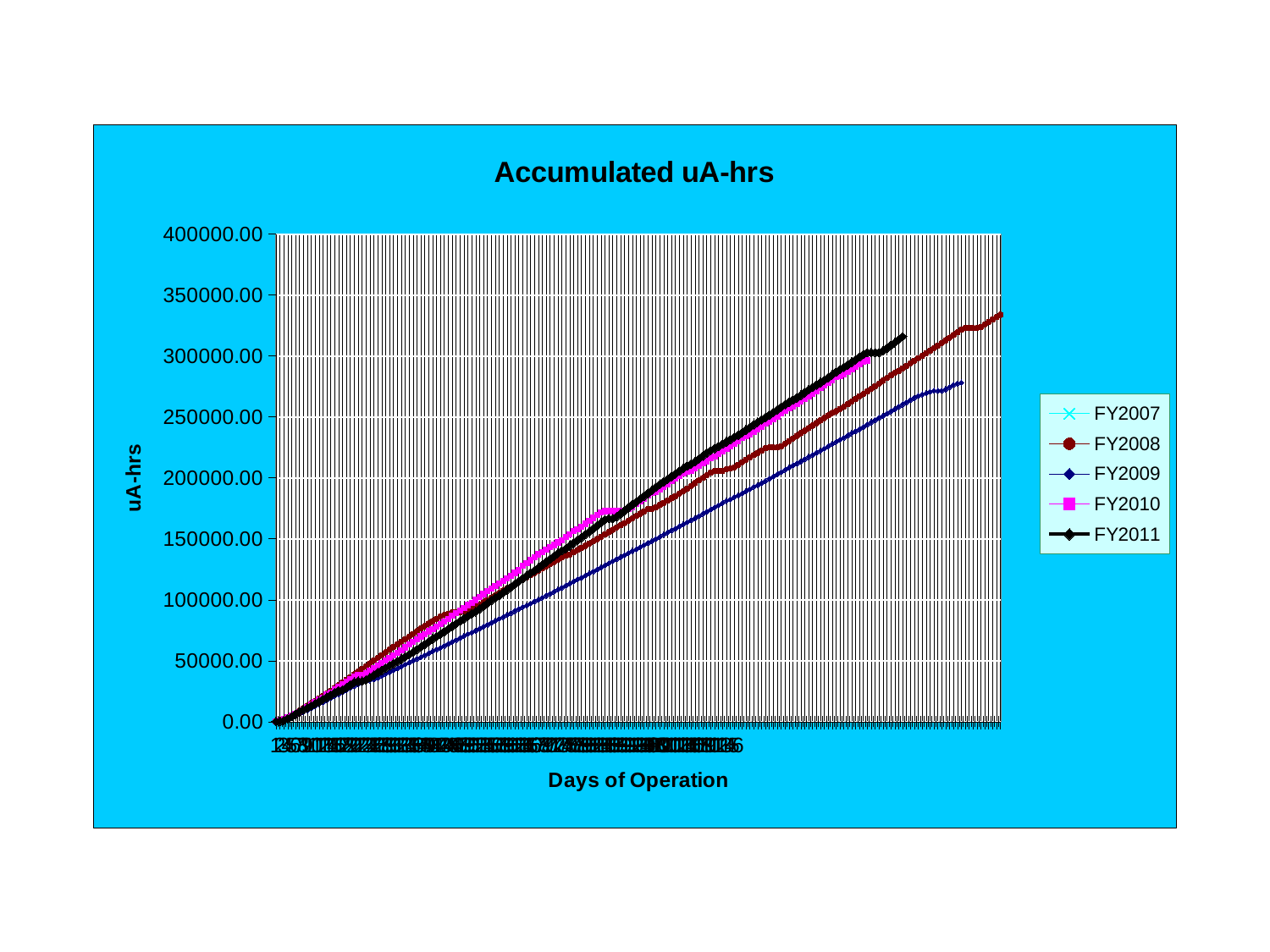
Is the final value of the FY2009 series greater or less than 300000.00? less Is the final value of the FY2011 series greater or less than 300000.00? greater Is the final value of the FY2008 series greater or less than 300000.00? greater What kind of chart is shown on the slide? line chart Which series ends at a higher value, FY2011 or FY2009? FY2011 Which series ends at a higher value, FY2008 or FY2009? FY2008 Do the plotted values rise or fall as days of operation increase? rise What is the highest value shown on the y axis? 400000.00 How many series does the legend list? 5 What is the label of the x axis? Days of Operation Which series reaches the highest accumulated uA-hrs value on the chart? FY2008 What is the title of the chart? Accumulated uA-hrs